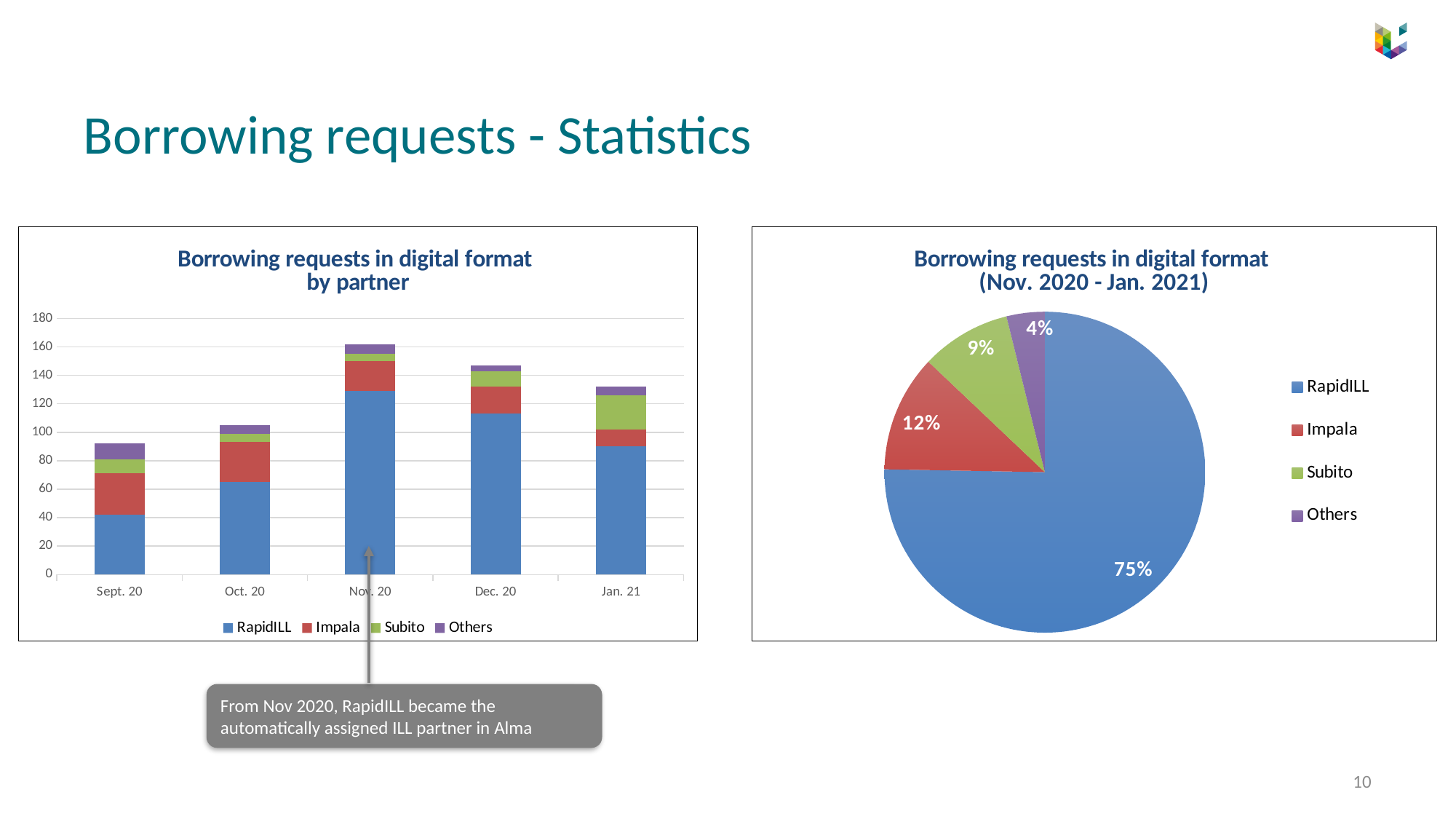
In the 'Borrowing requests in digital format (Nov. 2020 - Jan. 2021)' pie chart, what is the difference between the Impala and Subito shares? 3% In the 'Borrowing requests in digital format by partner' chart, is the RapidILL value for Nov. 20 greater or less than 100? greater In the 'Borrowing requests in digital format by partner' chart, how many months are shown on the x axis? 5 What kind of chart is the 'Borrowing requests in digital format by partner' chart? stacked bar chart In the 'Borrowing requests in digital format (Nov. 2020 - Jan. 2021)' pie chart, what share does RapidILL have? 75% In the 'Borrowing requests in digital format (Nov. 2020 - Jan. 2021)' pie chart, which partner has the smallest slice? Others In the 'Borrowing requests in digital format (Nov. 2020 - Jan. 2021)' pie chart, what share does Subito have? 9% In the 'Borrowing requests in digital format by partner' chart, how many series does the legend list? 4 In the 'Borrowing requests in digital format by partner' chart, which month has the shortest stacked bar? Sept. 20 In the 'Borrowing requests in digital format by partner' chart, is the total stacked bar for Sept. 20 greater or less than 100? less What kind of chart is the 'Borrowing requests in digital format (Nov. 2020 - Jan. 2021)' chart? pie chart In the 'Borrowing requests in digital format by partner' chart, which month has the tallest stacked bar? Nov. 20